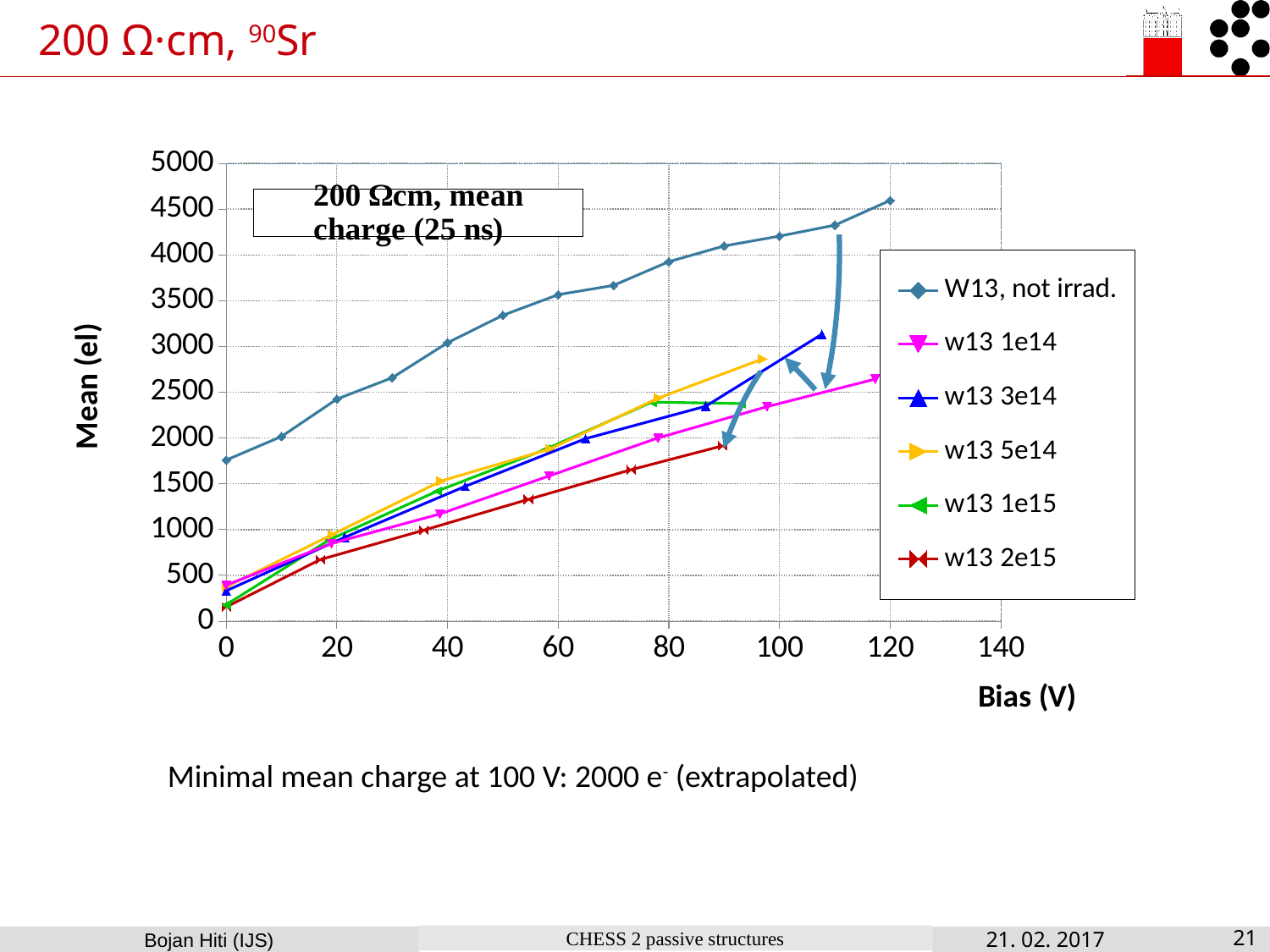
At 80 V, which series has the larger mean charge: w13 1e14 or w13 2e15? w13 1e14 What is the title shown inside the chart? 200 Ωcm, mean charge (25 ns) What kind of chart is shown on the slide? line chart Is the value for W13, not irrad. at 0 V greater or less than 1500? greater What is the label of the chart's x axis? Bias (V) Is the value for w13 2e15 at 0 V greater or less than 500? less Does the mean charge rise or fall as the bias increases for the W13, not irrad. series? rise Which series has the highest mean charge across the whole bias range? W13, not irrad. Is the value for W13, not irrad. at 80 V greater or less than 3500? greater How many series does the chart legend list? 6 Which series lies lowest across most of the bias range? w13 2e15 At 0 V, which series has the larger mean charge: W13, not irrad. or w13 2e15? W13, not irrad.